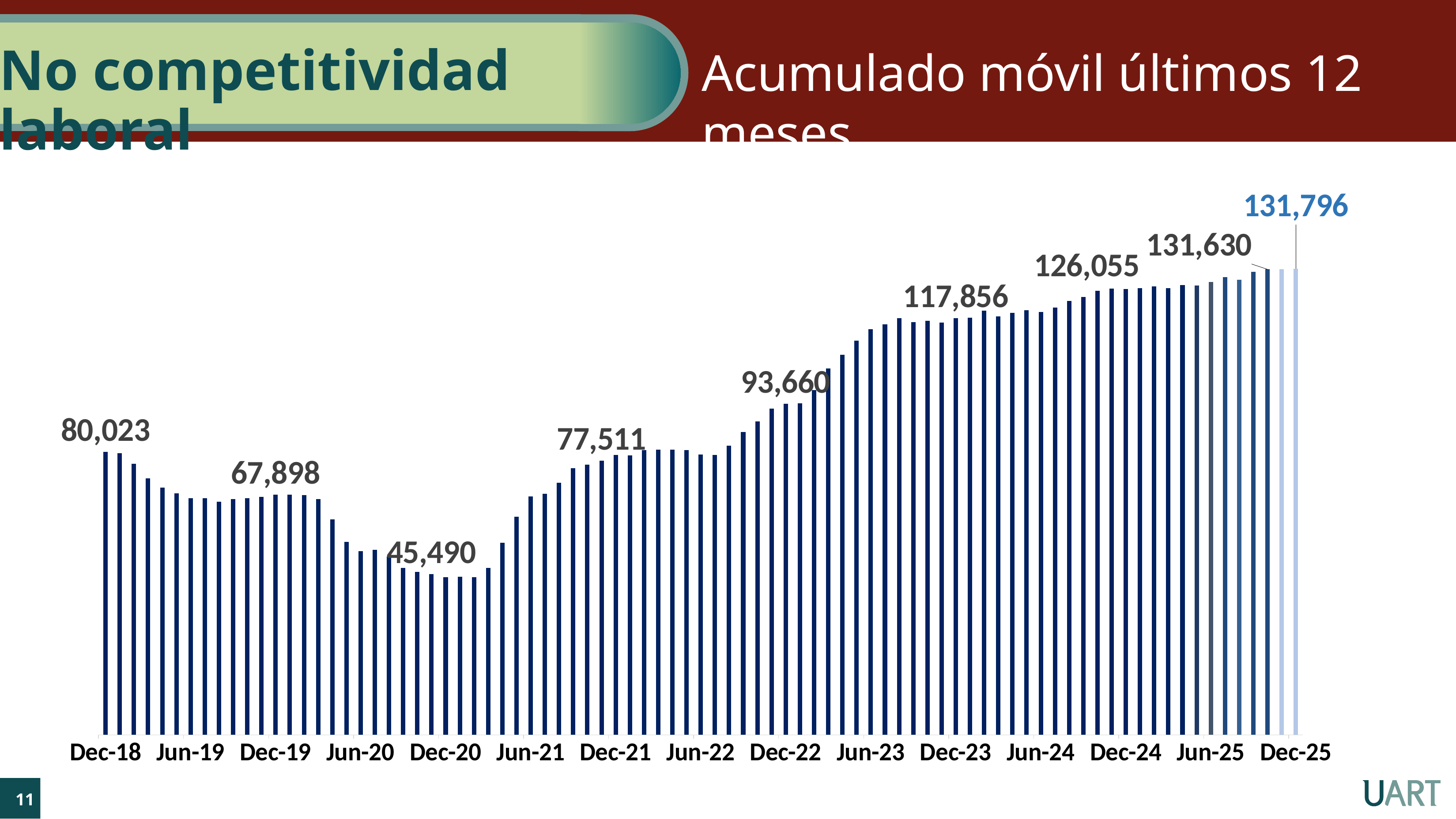
What is the value shown for Dec-18? 80,023 What is the value shown for Dec-22? 93,660 What is the difference between the Dec-25 value and the Dec-18 value? 51,773 What is the value shown for Dec-25? 131,796 Do the values generally rise or fall from Dec-20 to Dec-25? Rise What is the difference between the Dec-23 value and the Dec-22 value? 24,196 What is the value shown for Dec-24? 126,055 Which labeled value is the highest on the chart? 131,796 (Dec-25) What kind of chart is shown on the slide? Bar chart